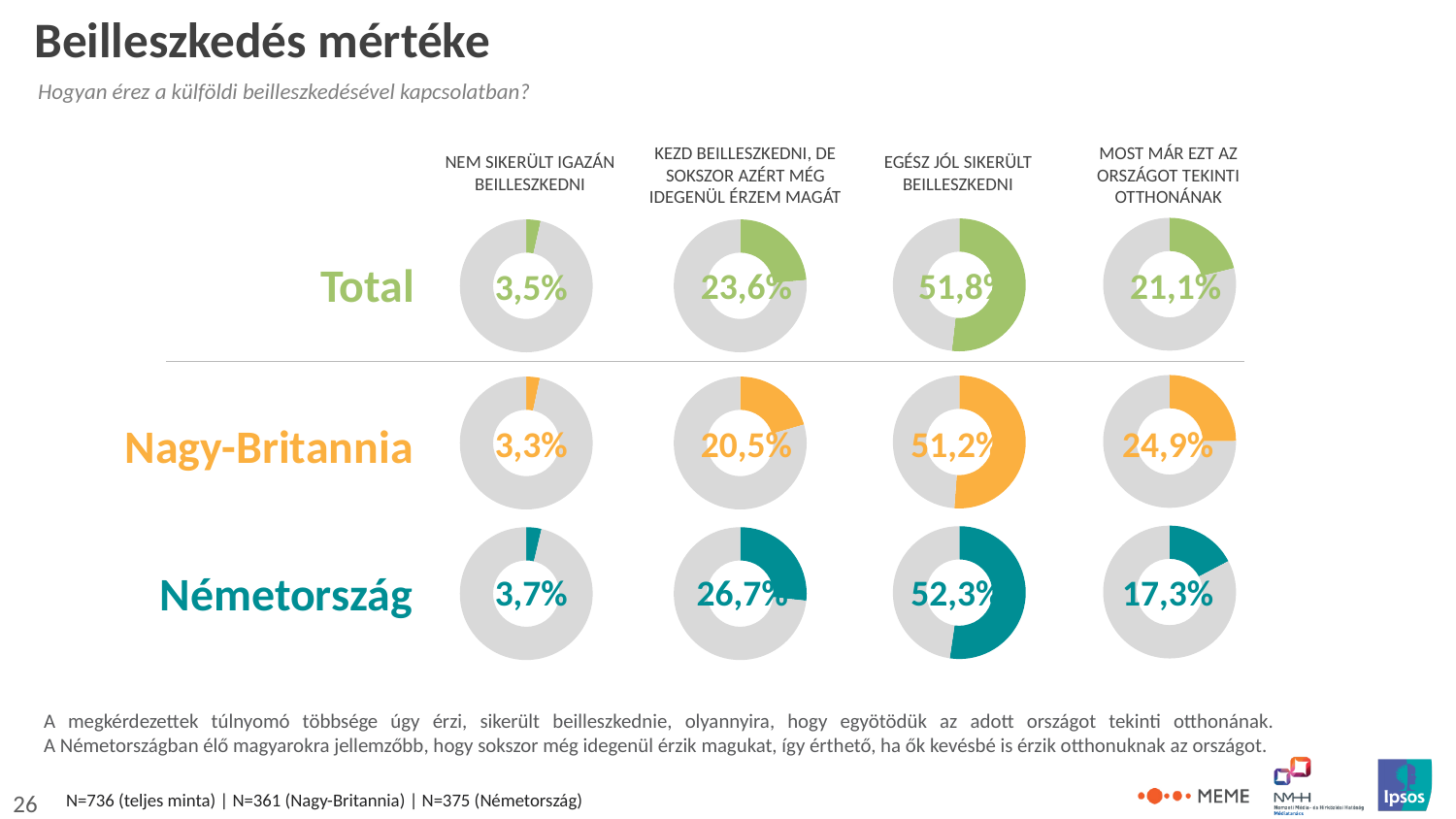
In the Total row, which category has the lowest value? Nem sikerült igazán beilleszkedni In the Nagy-Britannia row, what value is shown for "Nem sikerült igazán beilleszkedni"? 3,3% For "Most már ezt az országot tekinti otthonának", which is larger: the Nagy-Britannia value or the Németország value? Nagy-Britannia What colour are the filled segments in the Németország row? Teal In the Total row, what is the difference between "Egész jól sikerült beilleszkedni" and "Kezd beilleszkedni, de sokszor azért még idegenül érzem magát"? 28,2 percentage points In the Németország row, which category has the highest value? Egész jól sikerült beilleszkedni What kind of charts are used on this slide? Donut (pie) charts In the Németország row, what value is shown for "Kezd beilleszkedni, de sokszor azért még idegenül érzem magát"? 26,7% How many donut charts are shown on the slide? 12 In the Nagy-Britannia row, what value is shown for "Most már ezt az országot tekinti otthonának"? 24,9% In the Total row, what value is shown in the donut chart for "Egész jól sikerült beilleszkedni"? 51,8% For "Kezd beilleszkedni, de sokszor azért még idegenül érzem magát", what is the difference between the Németország value and the Nagy-Britannia value? 6,2 percentage points